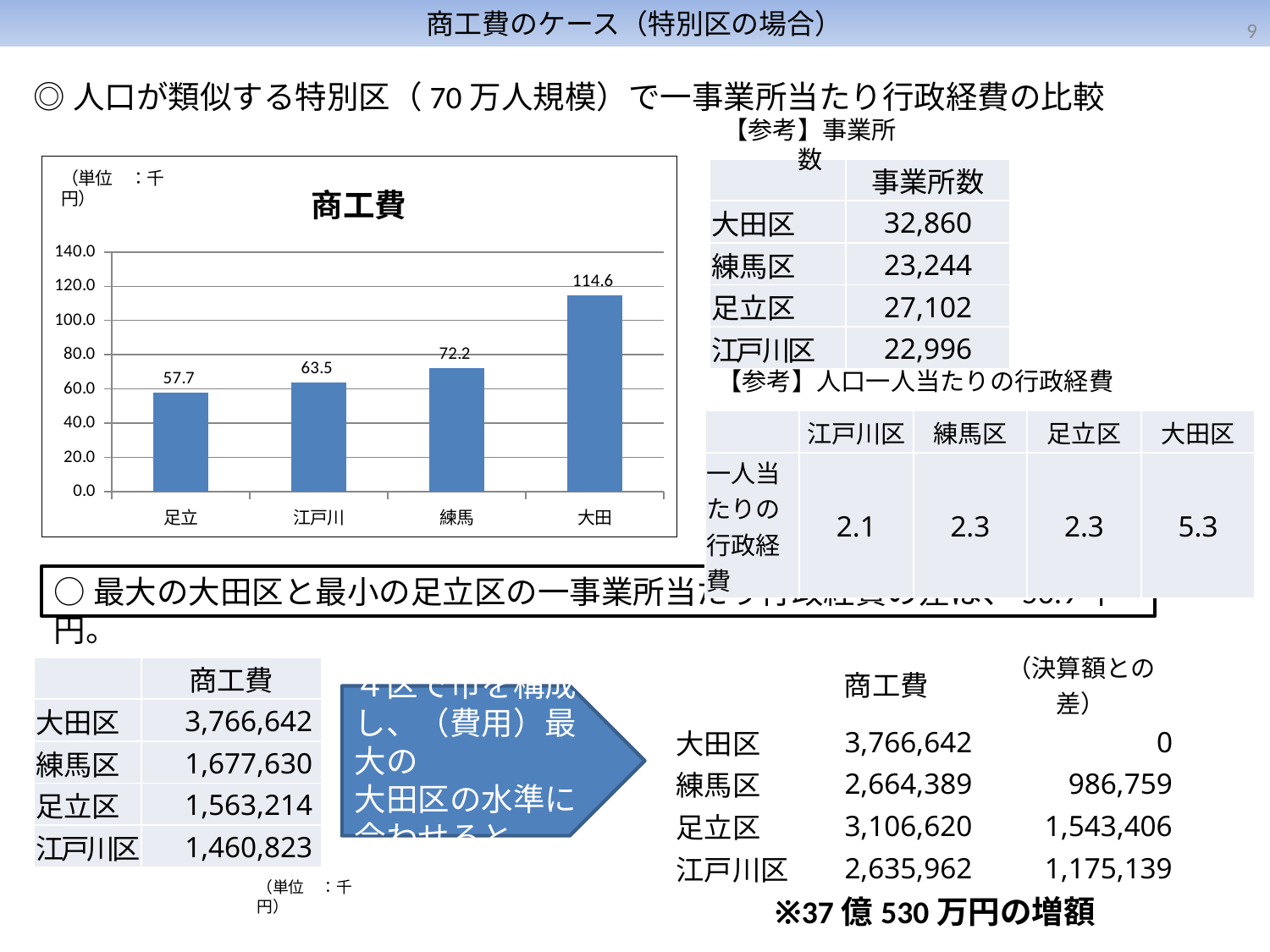
Which category has the highest value in the 商工費 chart? 大田 Which category has the lowest value in the 商工費 chart? 足立 Do the values in the 商工費 chart rise or fall from left to right along the x axis? rise Which is larger in the 商工費 chart, the value for 練馬 or the value for 江戸川? 練馬 What is the value for 江戸川 in the 商工費 chart? 63.5 What is the title of the chart? 商工費 What type of chart is shown on the slide? bar chart What is the difference between the values for 大田 and 足立 in the 商工費 chart? 56.9 What is the value for 大田 in the 商工費 chart? 114.6 What is the value for 練馬 in the 商工費 chart? 72.2 What is the value for 足立 in the 商工費 chart? 57.7 How many categories are plotted in the 商工費 chart? 4